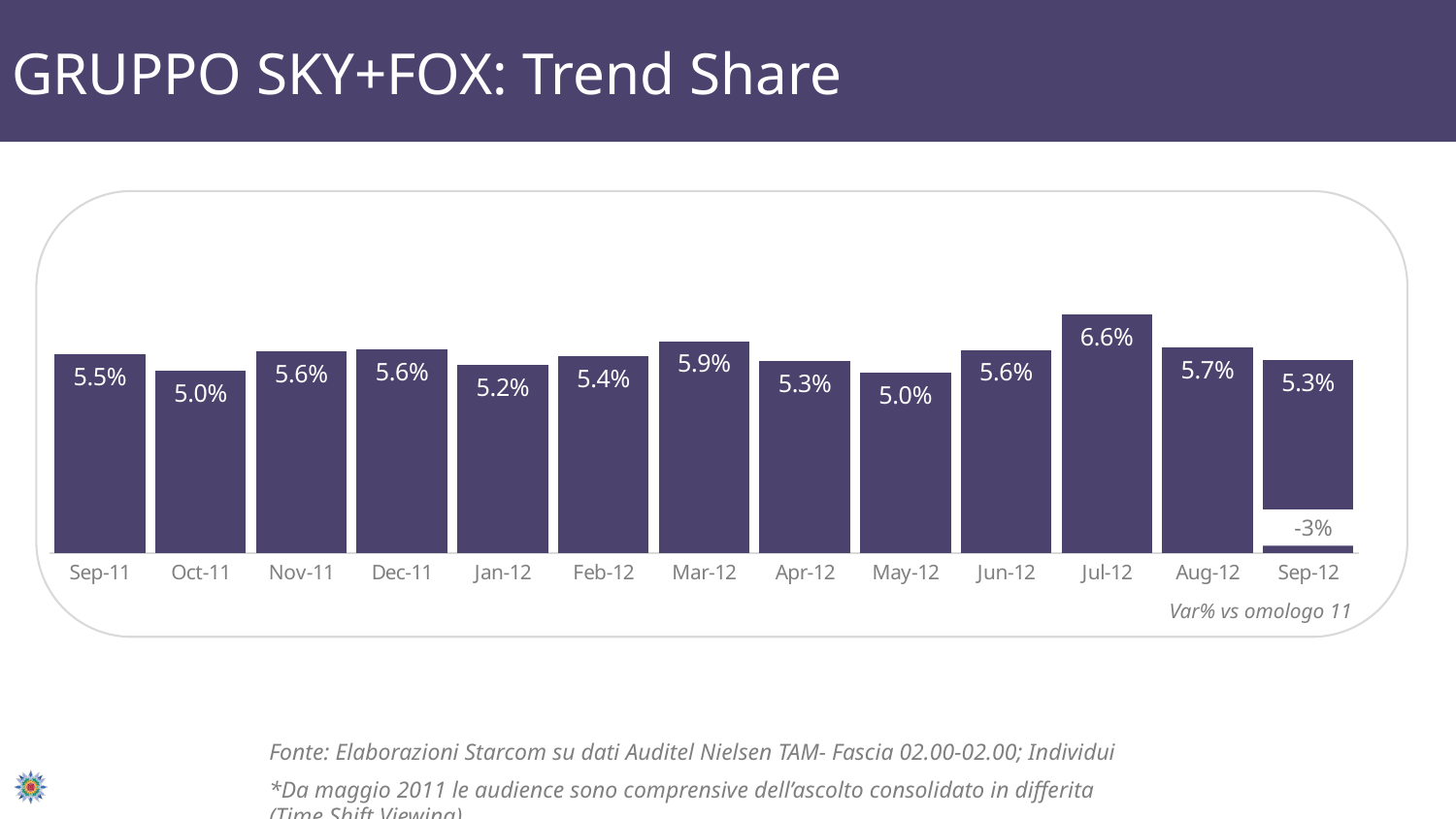
What is the difference between the share values for Sep-11 and Sep-12? 0.2 percentage points Which is larger, the share value for Mar-12 or for Apr-12? Mar-12 What kind of chart is shown on the slide? Bar chart What is the share value for Mar-12? 5.9% How many months are shown on the x axis? 13 What is the share value for Sep-11? 5.5% Which month has the highest share value? Jul-12 What is the share value for Sep-12? 5.3% What is the 'Var% vs omologo 11' value shown for Sep-12? -3% What is the share value for Jul-12? 6.6% What is the difference between the share values for Jul-12 and Sep-11? 1.1 percentage points Do the share values rise or fall from May-12 to Jul-12? Rise